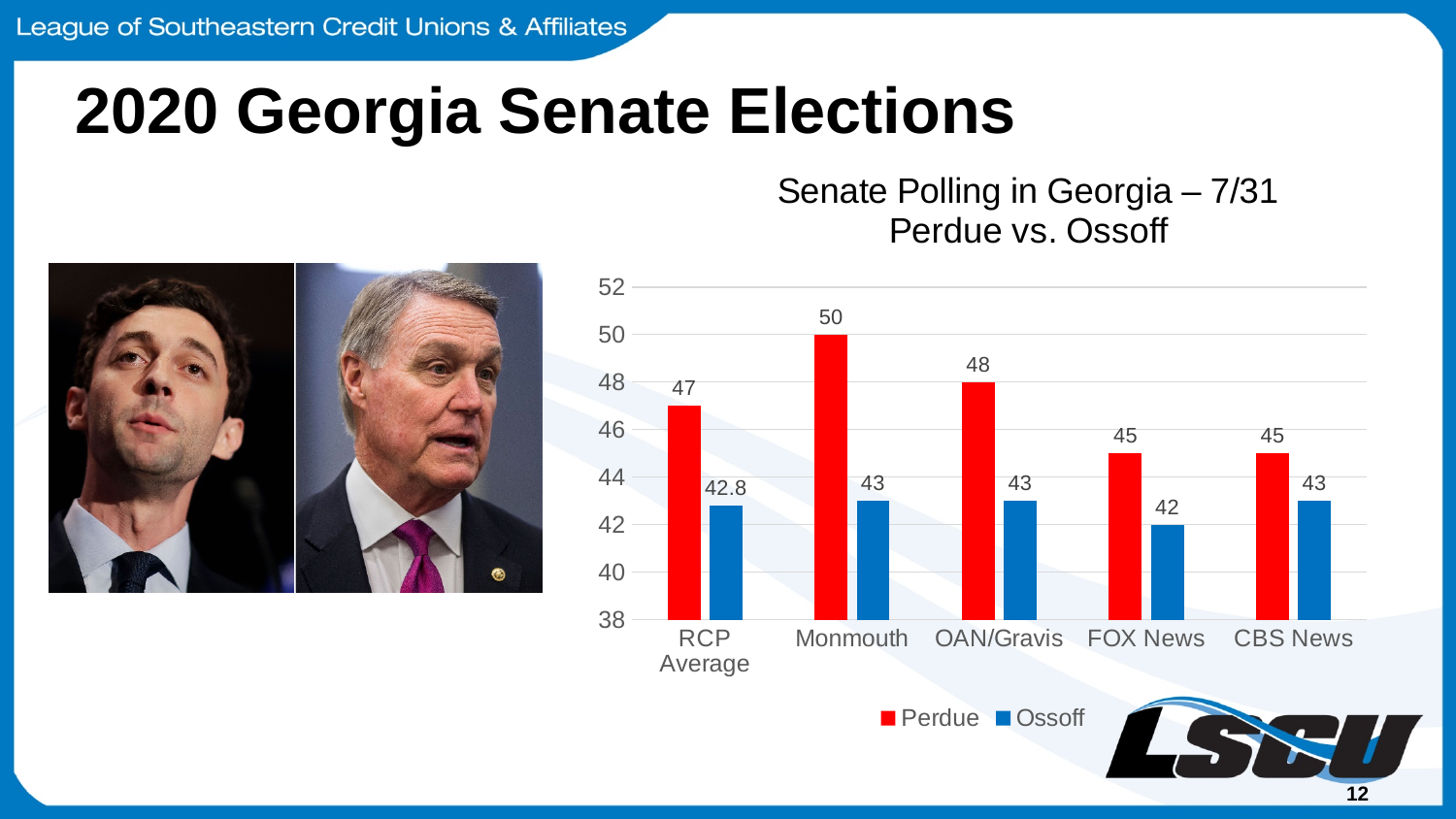
How many polls are shown on the x axis? 5 What kind of chart is shown? Bar chart What is Perdue's value for Monmouth? 50 Which poll shows the highest value for Perdue? Monmouth What is Ossoff's value for the RCP Average? 42.8 Which colour represents Ossoff in the chart? Blue What is the title of the chart? Senate Polling in Georgia – 7/31 Perdue vs. Ossoff What is Ossoff's value for FOX News? 42 How many series does the legend list? 2 Which poll shows the lowest value for Ossoff? FOX News What is the difference between Perdue and Ossoff in the Monmouth poll? 7 Which is larger: Perdue's value for OAN/Gravis or Perdue's value for CBS News? OAN/Gravis